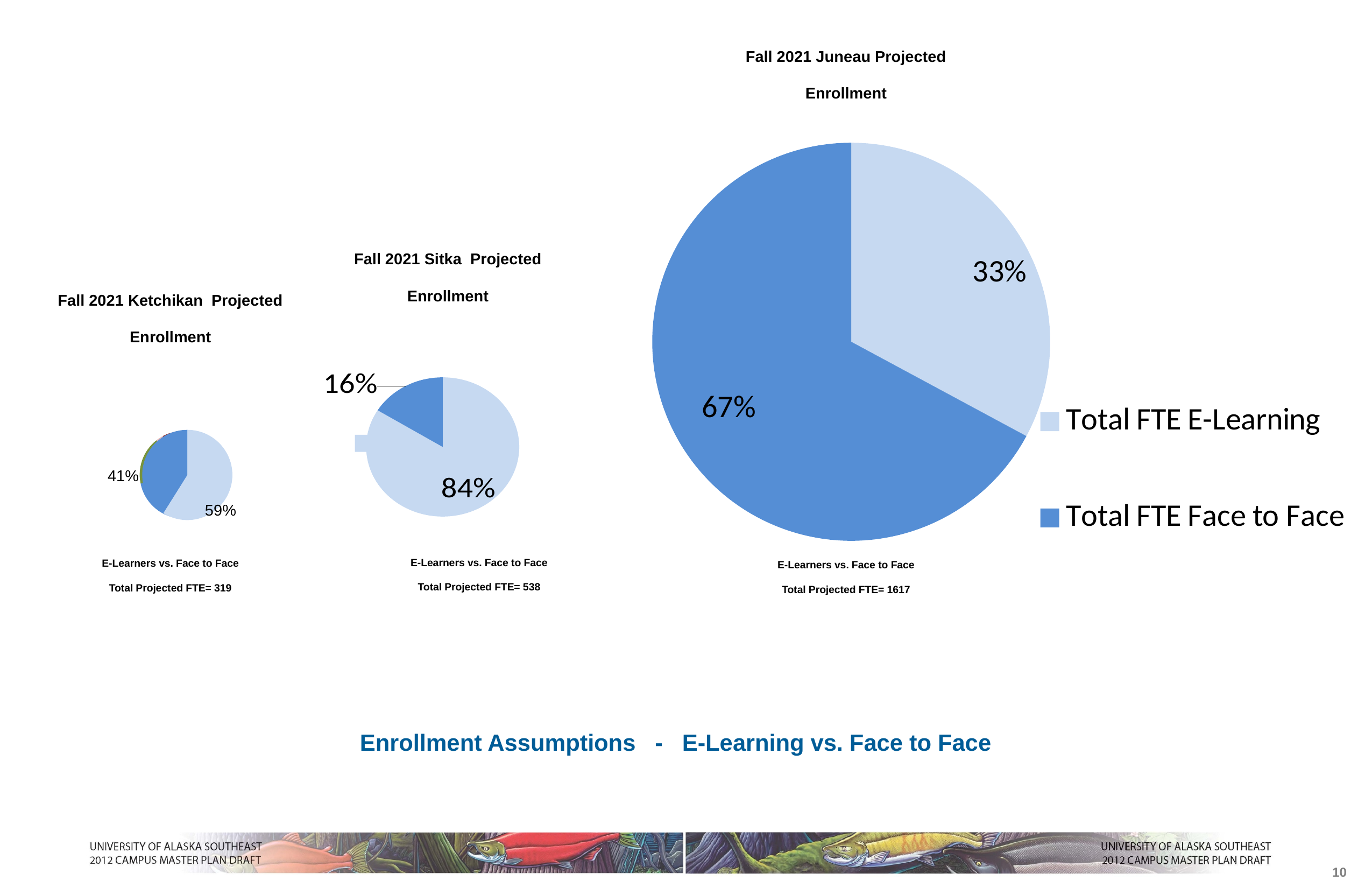
How many series does the legend of the Fall 2021 Juneau Projected Enrollment chart list? 2 In the Fall 2021 Sitka Projected Enrollment chart, what percentage is shown for the larger slice? 84% How many pie charts are shown on the slide? 3 In the Fall 2021 Juneau Projected Enrollment chart, what share of the pie is Total FTE Face to Face? 67% In the Fall 2021 Juneau Projected Enrollment chart, what share of the pie is Total FTE E-Learning? 33% In the Fall 2021 Ketchikan Projected Enrollment chart, what is the difference between the two slice percentages? 18% What is the Total Projected FTE stated below the Fall 2021 Juneau Projected Enrollment chart? 1617 What kind of chart is the Fall 2021 Juneau Projected Enrollment chart? pie chart What is the Total Projected FTE stated below the Fall 2021 Sitka Projected Enrollment chart? 538 In the Fall 2021 Juneau Projected Enrollment chart, which slice is larger, Total FTE E-Learning or Total FTE Face to Face? Total FTE Face to Face